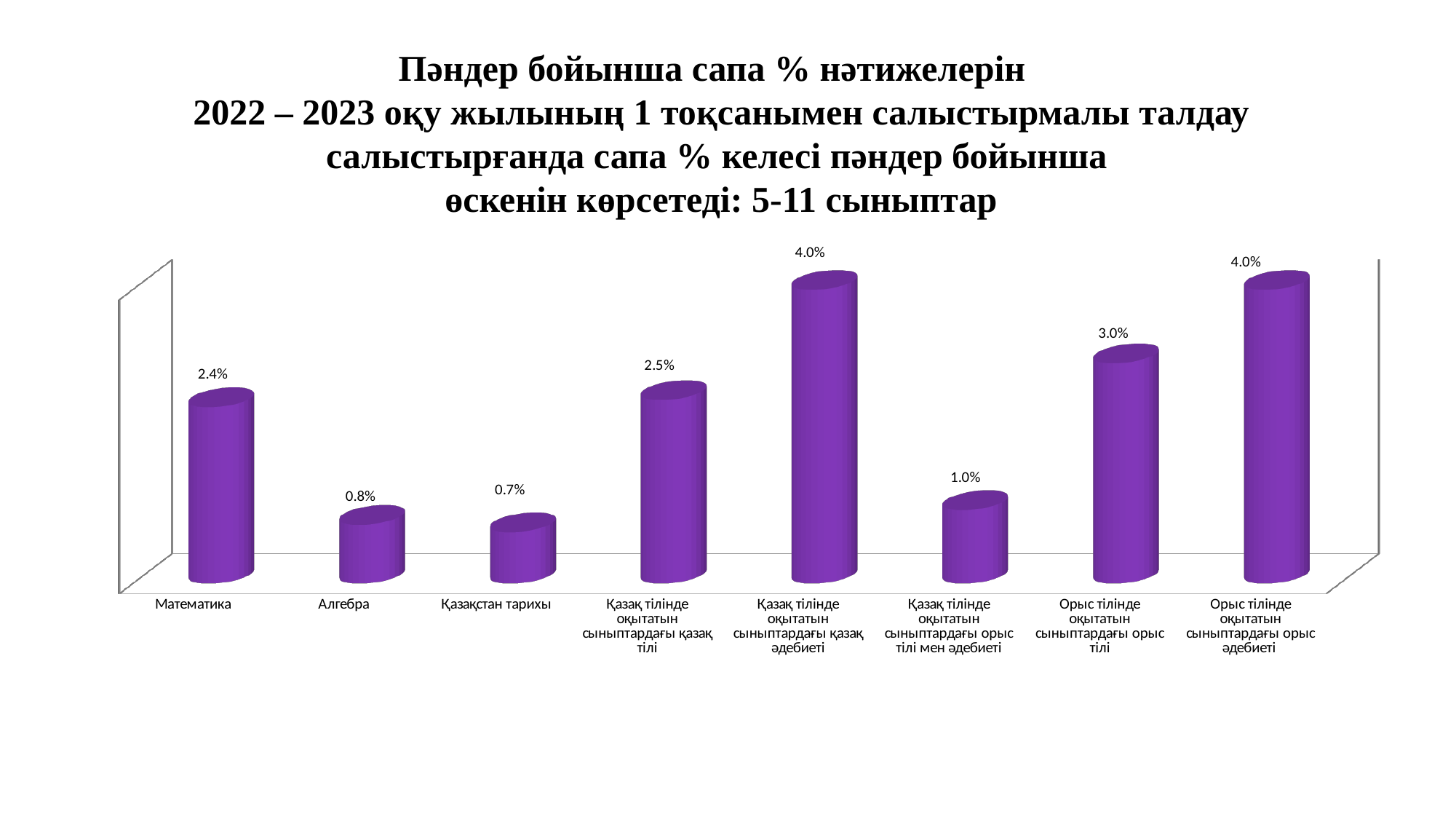
What is the value for Қазақстан тарихы? 0.7% Which is larger, the value for Орыс тілінде оқытатын сыныптардағы орыс тілі or the value for Қазақ тілінде оқытатын сыныптардағы орыс тілі мен әдебиеті? Орыс тілінде оқытатын сыныптардағы орыс тілі How many categories are shown in the chart? 8 What is the difference between the values for Орыс тілінде оқытатын сыныптардағы орыс тілі and Алгебра? 2.2% What is the value for Математика? 2.4% What is the value for Орыс тілінде оқытатын сыныптардағы орыс тілі? 3.0% Which is larger, the value for Математика or the value for Қазақ тілінде оқытатын сыныптардағы қазақ тілі? Қазақ тілінде оқытатын сыныптардағы қазақ тілі What is the difference between the values for Қазақ тілінде оқытатын сыныптардағы қазақ әдебиеті and Математика? 1.6% What kind of chart is shown on the slide? Bar chart Which category has the lowest value? Қазақстан тарихы What is the value for Алгебра? 0.8% What is the value for Қазақ тілінде оқытатын сыныптардағы орыс тілі мен әдебиеті? 1.0%